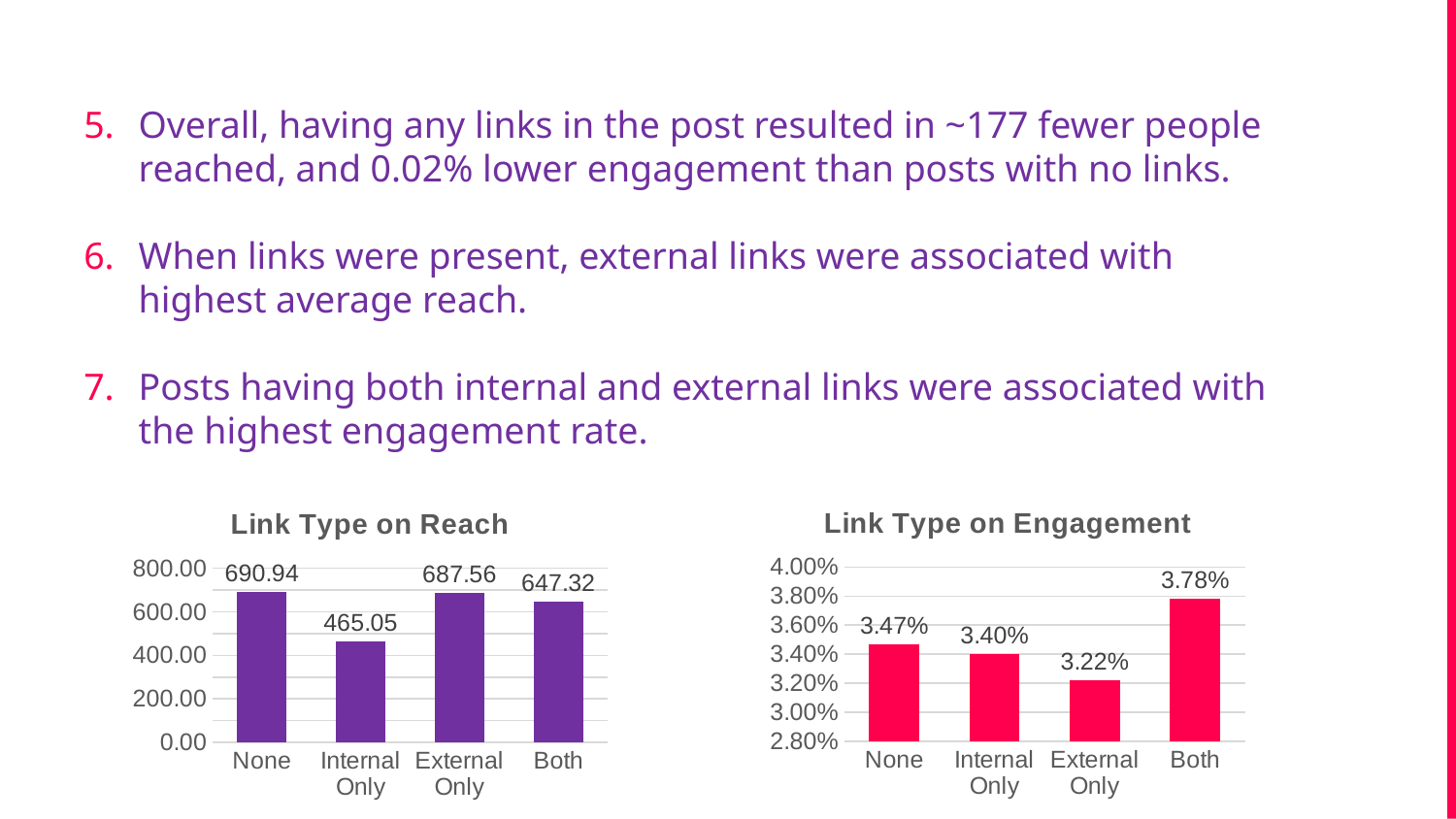
In the 'Link Type on Engagement' chart, what is the value for External Only? 3.22% In the 'Link Type on Reach' chart, what is the difference between the values for None and Internal Only? 225.89 In the 'Link Type on Reach' chart, what is the value for Internal Only? 465.05 In the 'Link Type on Reach' chart, which category has the lowest value? Internal Only In the 'Link Type on Engagement' chart, which category has the highest value? Both In the 'Link Type on Engagement' chart, what is the difference between the values for Both and None? 0.31% How many categories are shown in the 'Link Type on Engagement' chart? 4 In the 'Link Type on Reach' chart, which is larger, the value for External Only or the value for Both? External Only In the 'Link Type on Engagement' chart, which category has the lowest value? External Only What type of chart is 'Link Type on Reach'? Bar chart In the 'Link Type on Reach' chart, what is the value for None? 690.94 In the 'Link Type on Engagement' chart, what is the value for Both? 3.78%